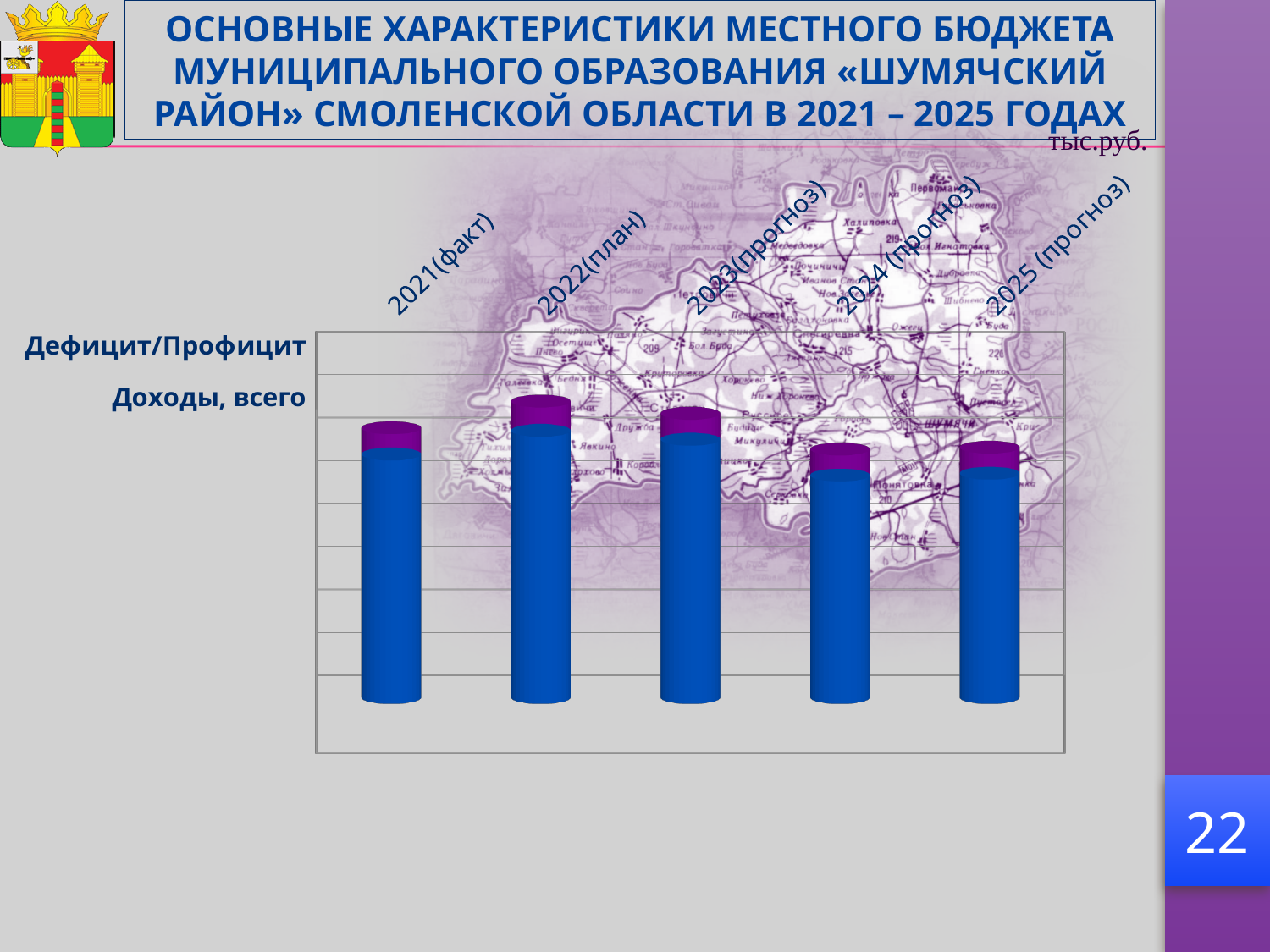
What kind of chart is shown on the slide? bar chart Which bar is taller, 2022(план) or 2024 (прогноз)? 2022(план) Which bar is taller, 2023(прогноз) or 2025 (прогноз)? 2023(прогноз) Do the bars rise or fall from 2021(факт) to 2022(план)? rise How many categories (years) are shown along the x axis of the chart? 5 Which bar is taller, 2021(факт) or 2023(прогноз)? 2023(прогноз) Do the bars rise or fall from 2022(план) to 2024 (прогноз)? fall What unit is indicated for the chart's values? тыс.руб. Which year has the tallest bar in the chart? 2022(план)